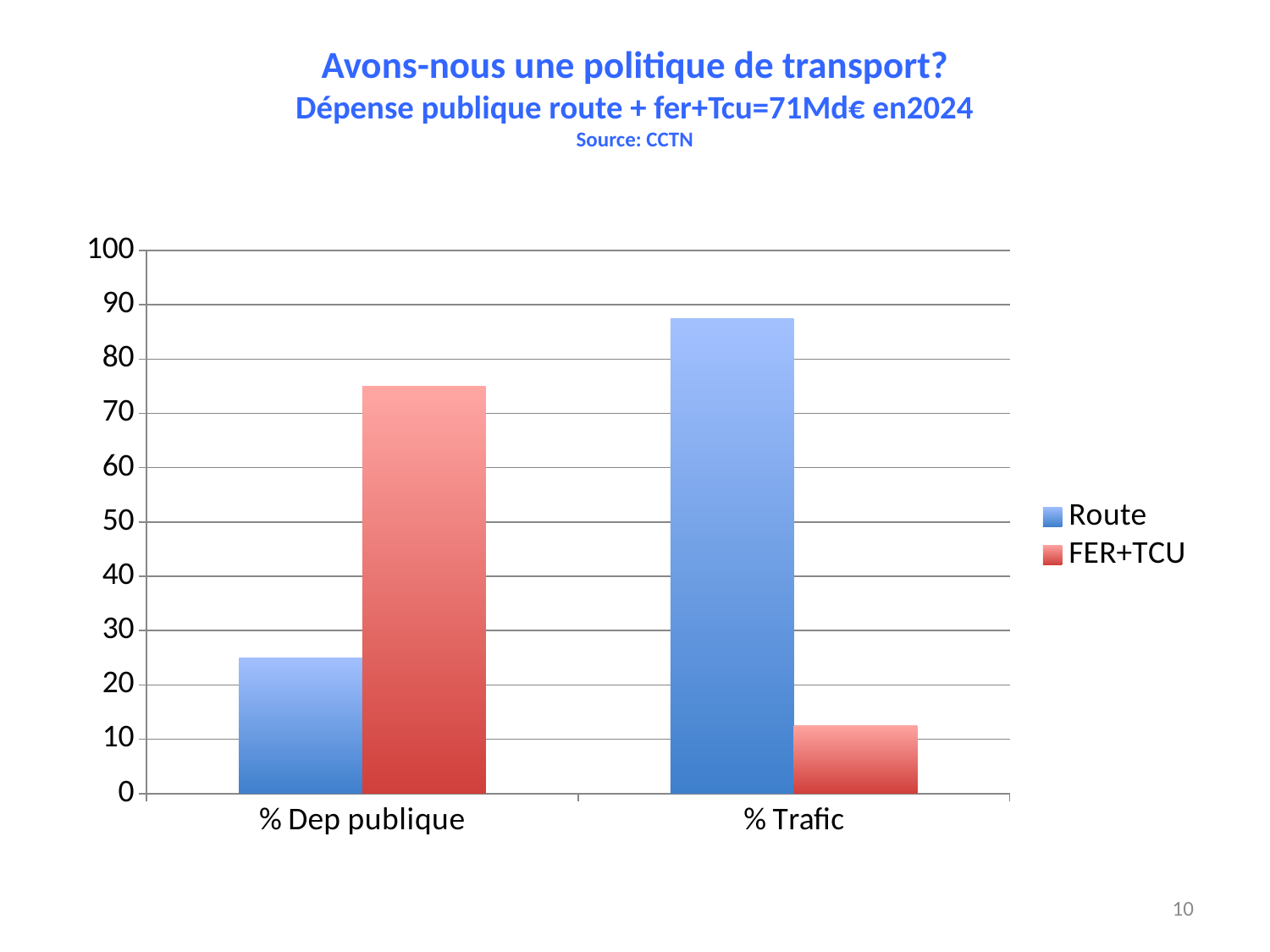
How many categories are shown on the x axis? 2 Which series is shown in red? FER+TCU Is the value for Route in % Dep publique greater or less than 30? less What kind of chart is shown on the slide? bar chart Which bar is the tallest in the chart? Route in % Trafic Is the value for Route in % Trafic greater or less than 80? greater In the % Dep publique category, which series has the larger value, Route or FER+TCU? FER+TCU In the % Trafic category, which series has the larger value, Route or FER+TCU? Route Is the value for FER+TCU in % Trafic greater or less than 20? less How many series does the legend list? 2 What is the title of the chart? Avons-nous une politique de transport?